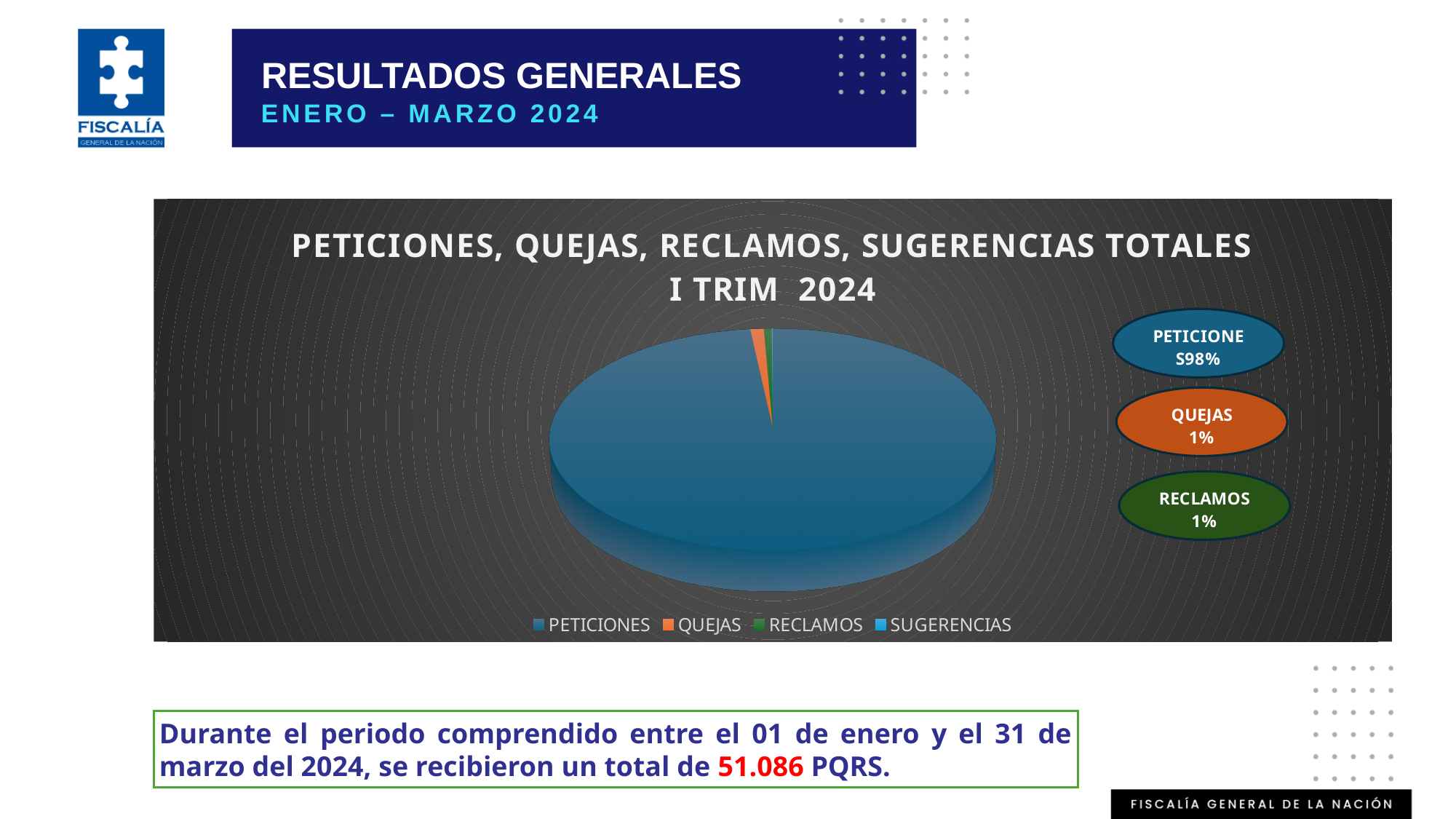
What share of the pie does PETICIONES represent? 98% What share of the pie does QUEJAS represent? 1% How many entries does the chart legend list? 4 Which legend entry is shown in orange? QUEJAS What kind of chart is shown on the slide? pie chart Is the share for PETICIONES greater or less than 50%? greater Which is larger, the share for PETICIONES or the share for QUEJAS? PETICIONES Which category has the largest slice of the pie? PETICIONES What is the title of the chart? PETICIONES, QUEJAS, RECLAMOS, SUGERENCIAS TOTALES I TRIM 2024 What share of the pie does RECLAMOS represent? 1% What is the difference in percentage points between the PETICIONES share and the RECLAMOS share? 97%